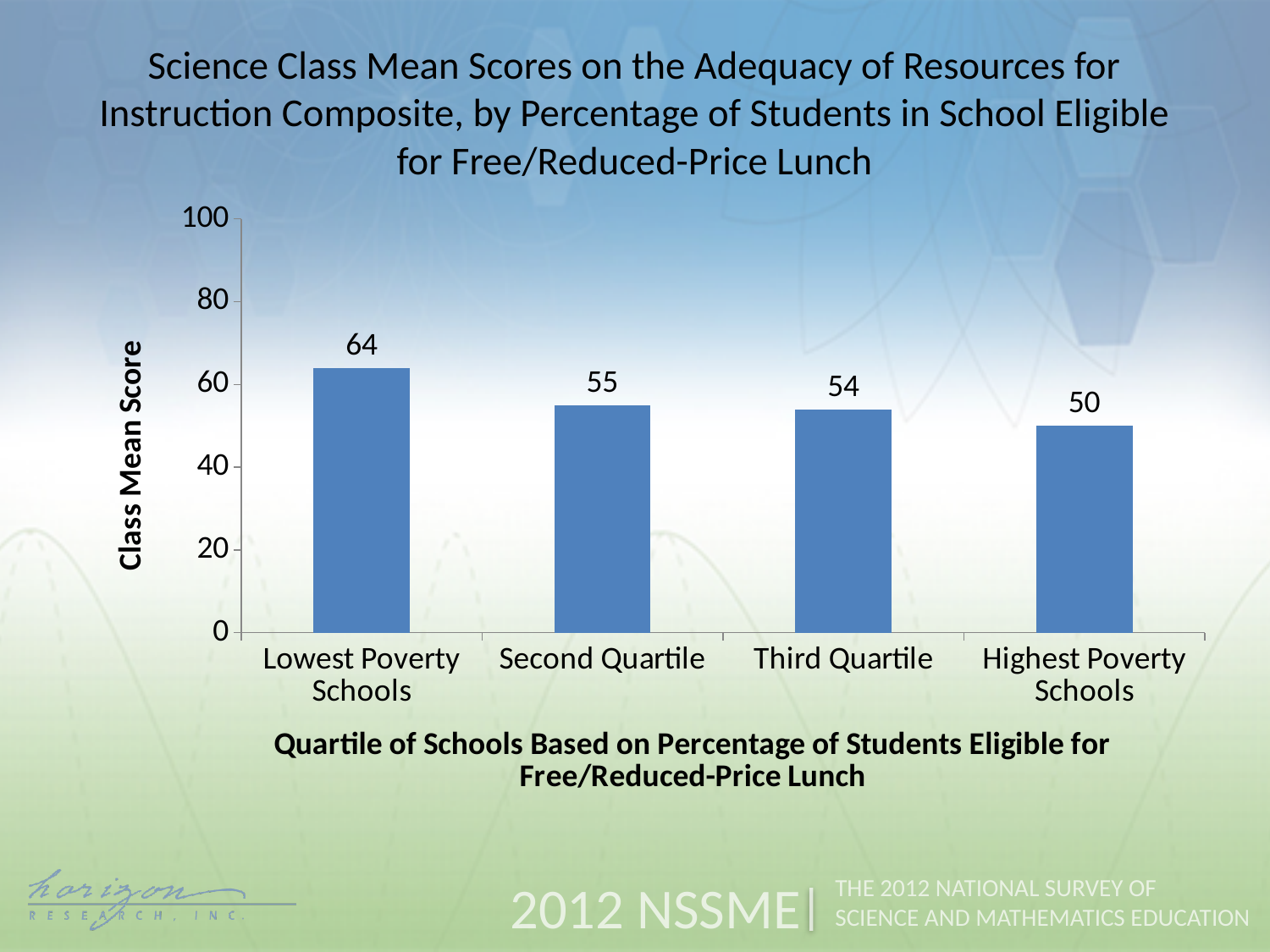
Which has a higher class mean score, the Second Quartile or Highest Poverty Schools? Second Quartile What is the class mean score for the Third Quartile? 54 How many quartile categories are shown on the chart? 4 What kind of chart is shown on the slide? Bar chart Which quartile has the lowest class mean score? Highest Poverty Schools What is the class mean score for the Second Quartile? 55 What is the class mean score for Highest Poverty Schools? 50 What is the class mean score for Lowest Poverty Schools? 64 Do the class mean scores rise or fall from Lowest Poverty Schools to Highest Poverty Schools? Fall What is the difference between the class mean scores of Lowest Poverty Schools and Highest Poverty Schools? 14 Which quartile has the highest class mean score? Lowest Poverty Schools Is the value for Lowest Poverty Schools greater or less than 60? greater